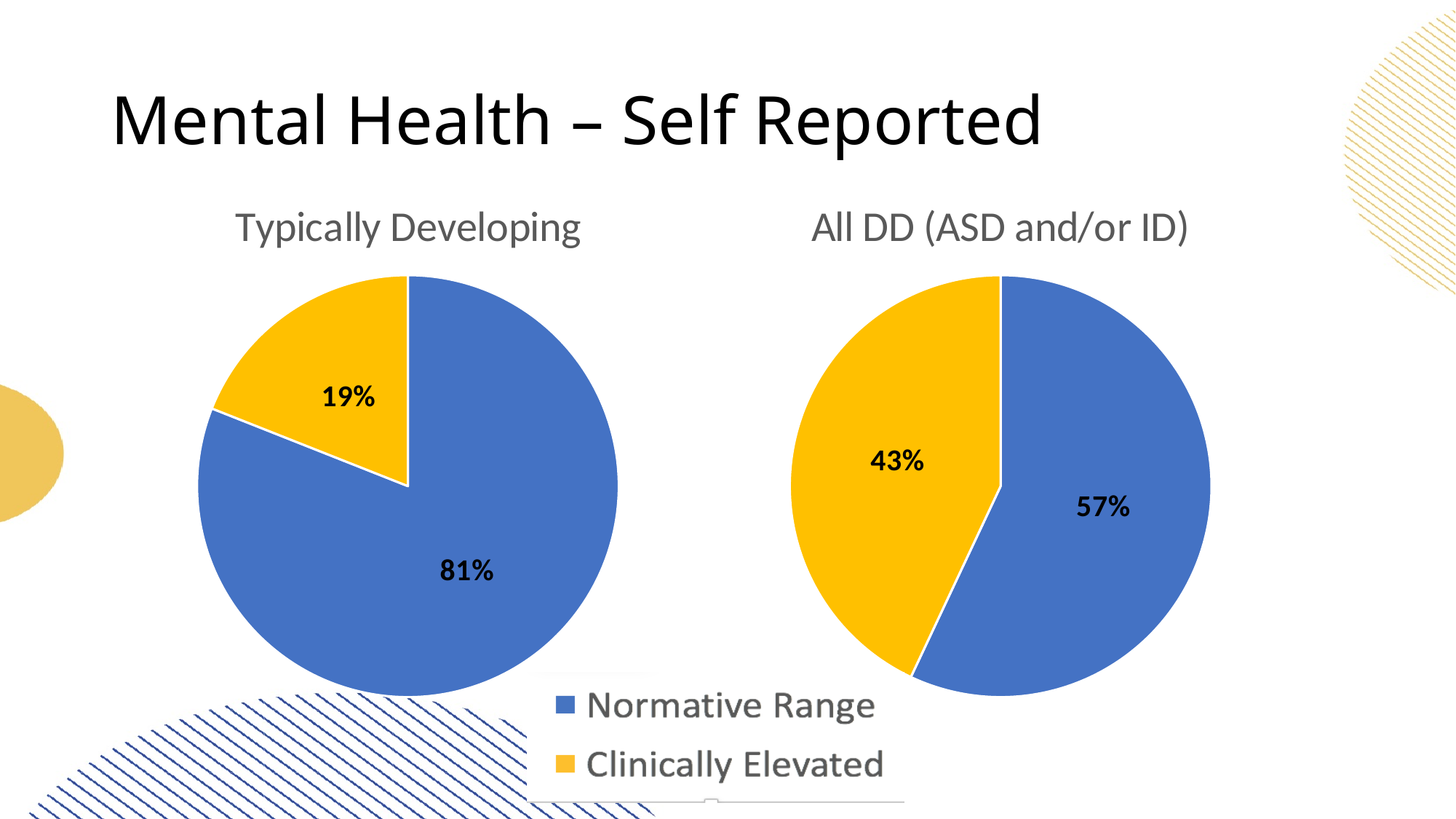
In the All DD (ASD and/or ID) pie chart, what percentage is in the Normative Range? 57% How many entries does the legend list? 2 What is the difference between the Clinically Elevated share in the All DD (ASD and/or ID) chart and the Clinically Elevated share in the Typically Developing chart? 24 percentage points In the All DD (ASD and/or ID) pie chart, what percentage is Clinically Elevated? 43% What is the difference between the Normative Range share and the Clinically Elevated share in the All DD (ASD and/or ID) chart? 14 percentage points In the Typically Developing pie chart, what percentage is Clinically Elevated? 19% In the All DD (ASD and/or ID) pie chart, which slice is larger, Normative Range or Clinically Elevated? Normative Range In the Typically Developing pie chart, which slice is the smallest? Clinically Elevated Which colour represents Clinically Elevated in the legend? Yellow How many slices does the Typically Developing pie chart have? 2 What type of chart is used on this slide? Pie chart In the Typically Developing pie chart, what percentage is in the Normative Range? 81%